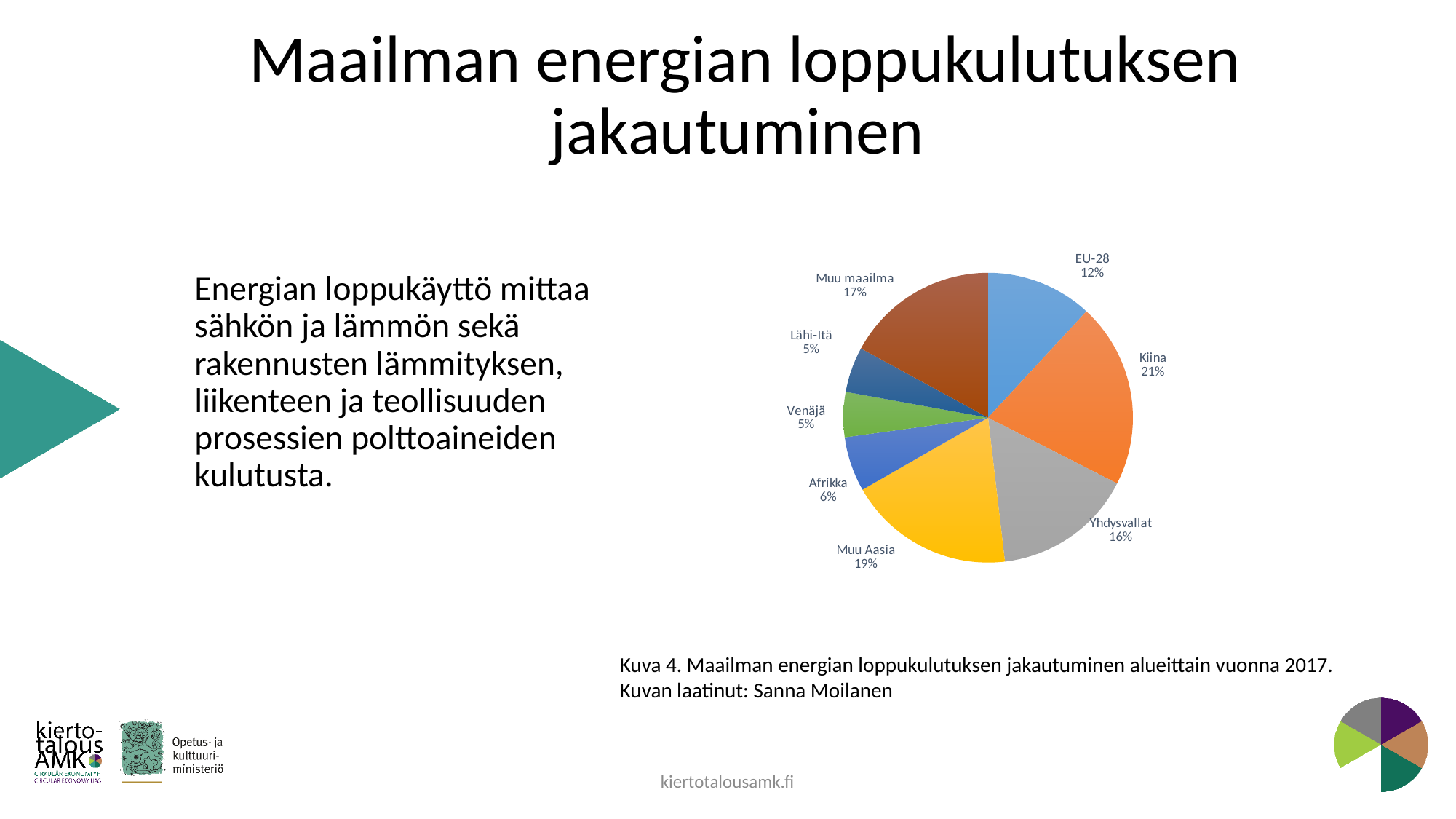
What is the value shown for Yhdysvallat? 16% What percentage is shown for Muu Aasia? 19% What is the combined share of Venäjä and Lähi-Itä? 10% What percentage is shown for Afrikka? 6% What share of the pie does Kiina have? 21% What kind of chart is shown on the slide? pie chart Which is larger, the share for Muu maailma or the share for Yhdysvallat? Muu maailma What is the difference between the shares of Kiina and Yhdysvallat? 5% According to the caption, which year does the chart describe? 2017 How many slices does the pie chart have? 8 Which region has the largest slice of the pie? Kiina What is the value shown for EU-28? 12%